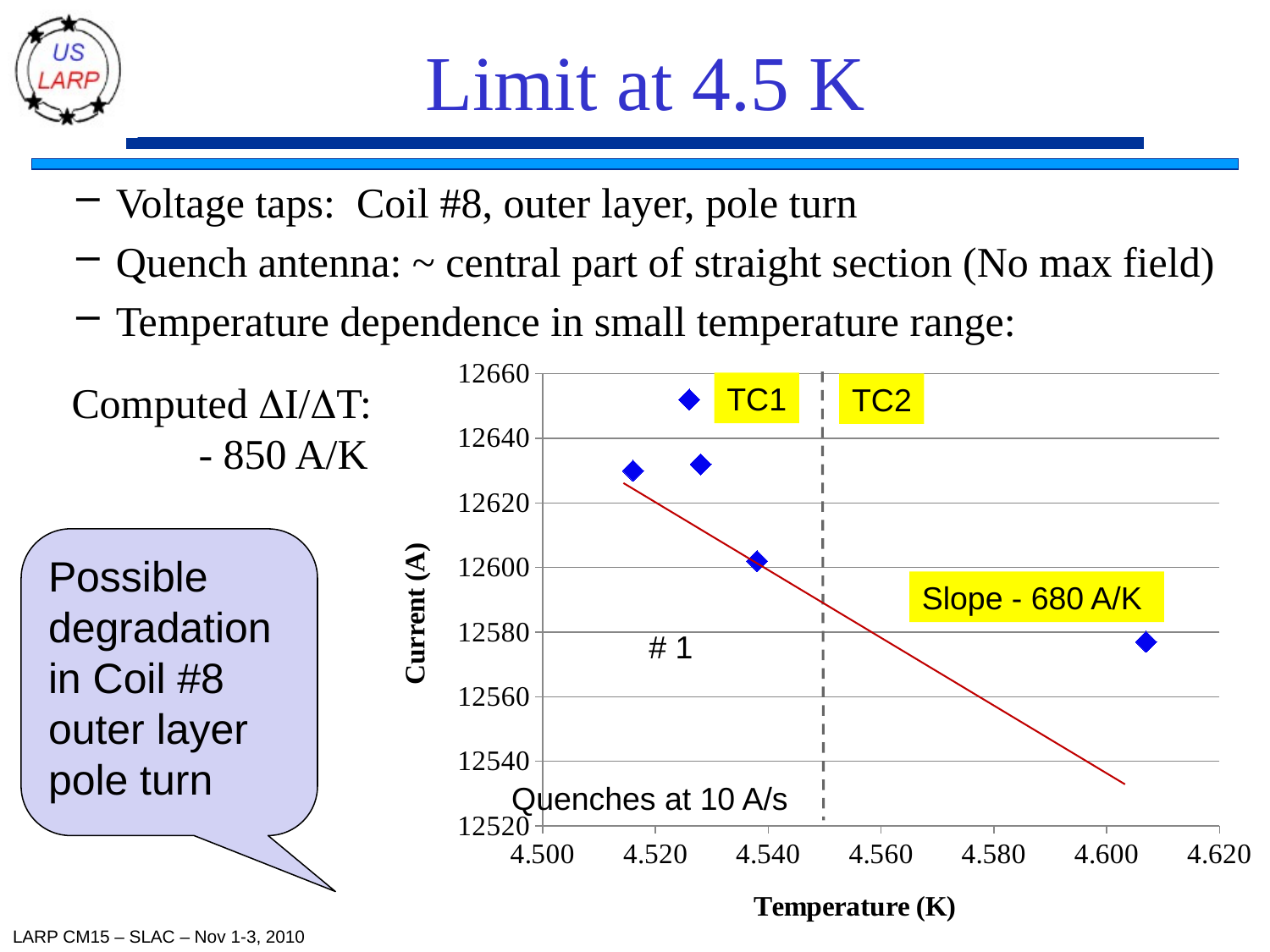
Is the current of the data point near 4.538 K greater or less than 12620 A? less What is the title of the chart's y axis? Current (A) What slope is stated in the annotation on the chart? Slope - 680 A/K As temperature increases along the x axis, does the current generally rise or fall? fall Is the current of the leftmost data point (near 4.516 K) greater or less than 12620 A? greater Which has the higher current: the data point near 4.538 K or the data point near 4.607 K? the point near 4.538 K Is the current of the highest plotted point greater or less than 12640 A? greater What kind of chart is shown on the slide? scatter chart